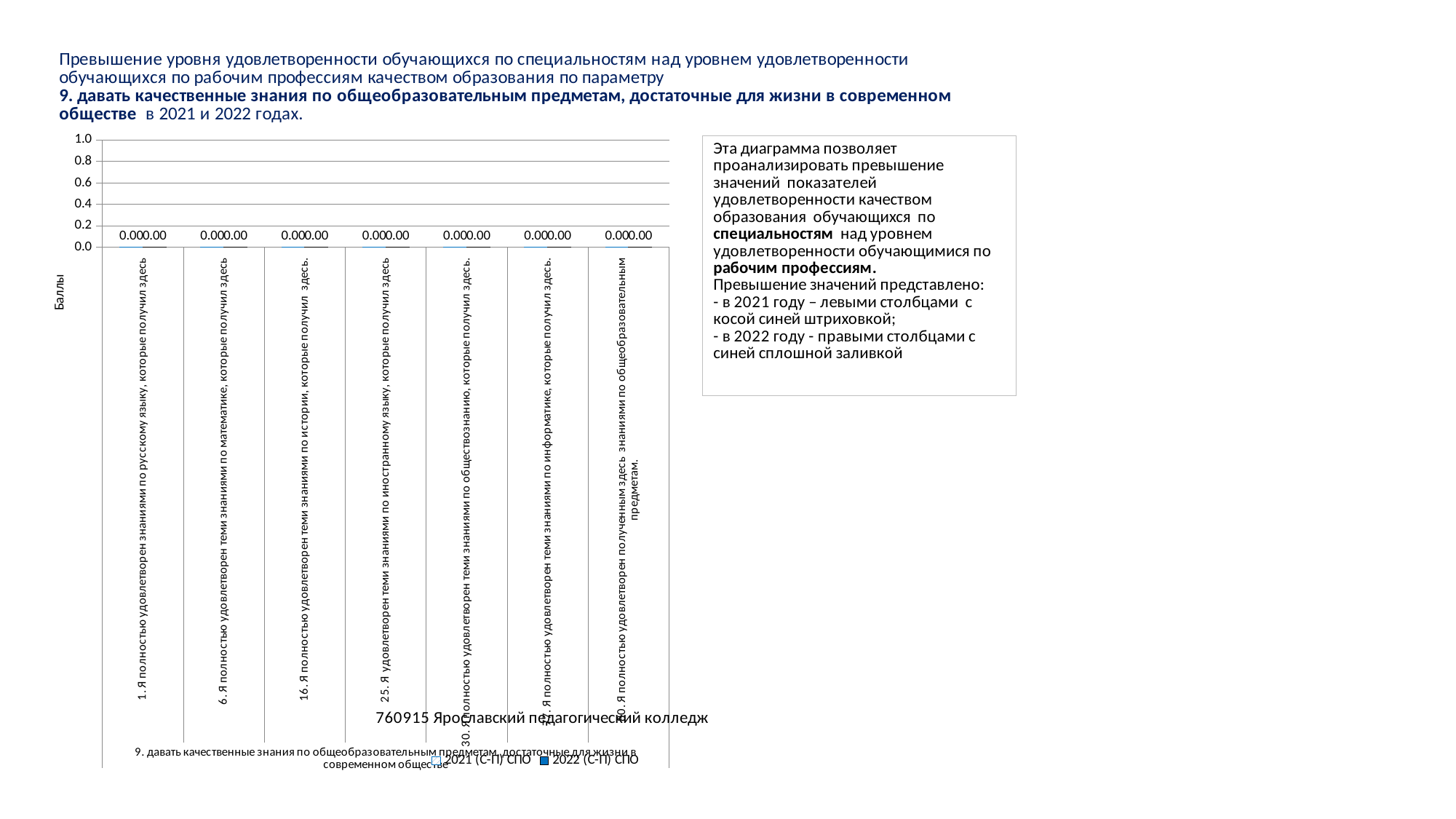
Is the value for the category about foreign language (25. Я удовлетворен теми знаниями по иностранному языку, которые получил здесь) greater or less than 0.4? less How many series does the chart legend list? 2 What kind of chart is shown on the slide? bar chart What data label is printed above the first category (1. Я полностью удовлетворен знаниями по русскому языку, которые получил здесь)? 0.00 What data label is printed above the category about mathematics (6. Я полностью удовлетворен теми знаниями по математике, которые получил здесь)? 0.00 What is the label of the vertical axis of the chart? Баллы Do the data labels printed on the chart differ between categories, or are they all the same? all the same Is the value for the category about history (16. Я полностью удовлетворен теми знаниями по истории, которые получил здесь) greater or less than 0.2? less What is the highest tick value shown on the vertical axis of the chart? 1.0 What are the two series named in the chart legend? 2021 (С-П) СПО and 2022 (С-П) СПО How many categories are shown along the x axis of the chart? 7